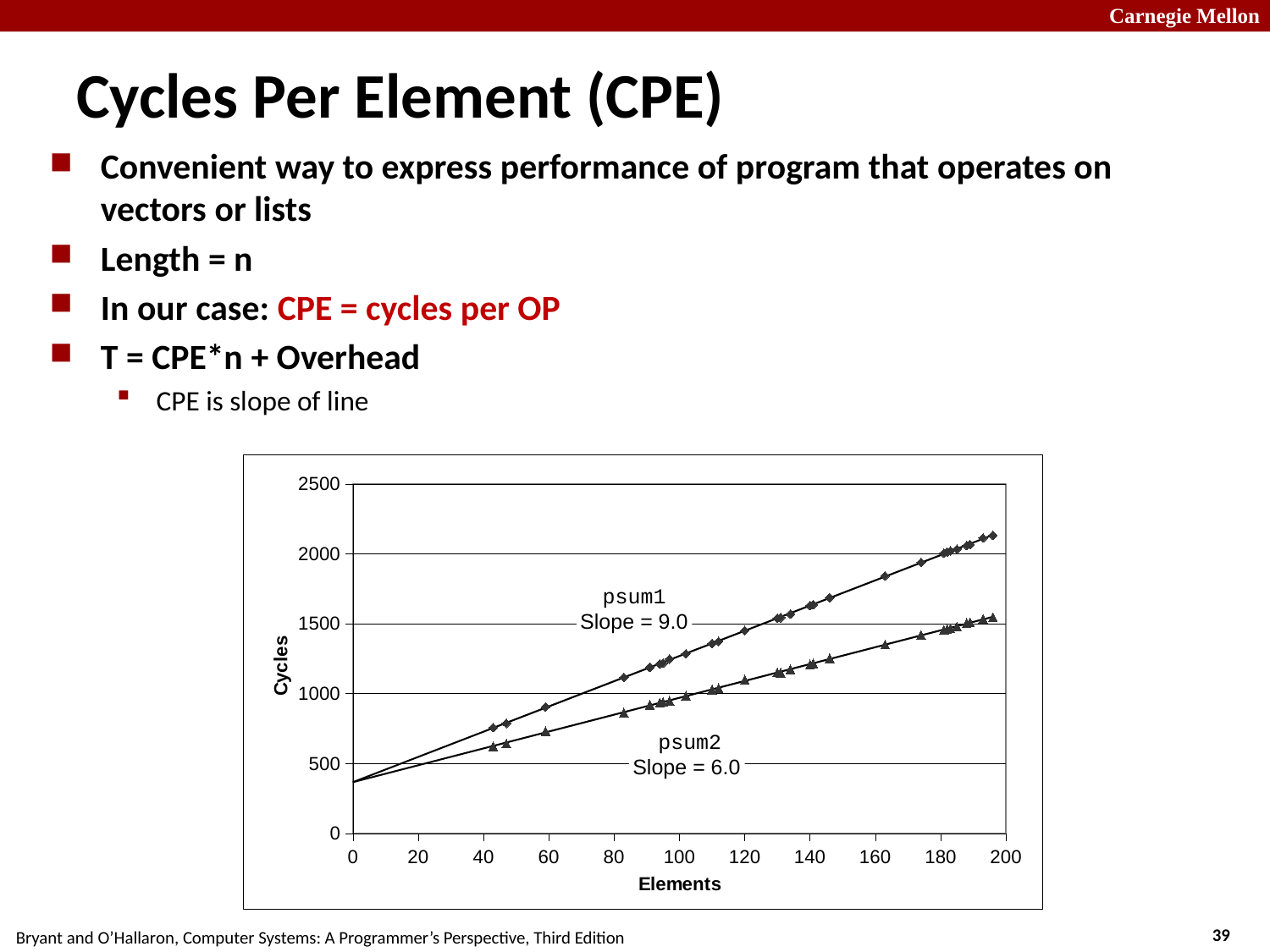
Is the value for psum2 at about 195 elements greater or less than 2000 cycles? less What is the difference between the printed slopes of psum1 and psum2? 3.0 Which series reaches the higher number of cycles at the right end of the chart? psum1 What is the slope printed for the psum1 series? 9.0 Do the cycles for both series rise or fall as the number of elements increases? rise Which series has the larger slope, psum1 or psum2? psum1 What is the label on the x axis of the chart? Elements What kind of chart is shown on the slide? scatter chart How many data series are plotted on the chart? 2 What is the slope printed for the psum2 series? 6.0 Is the value for psum1 at about 195 elements greater or less than 2000 cycles? greater Is the value for psum1 at about 100 elements greater or less than 1000 cycles? greater